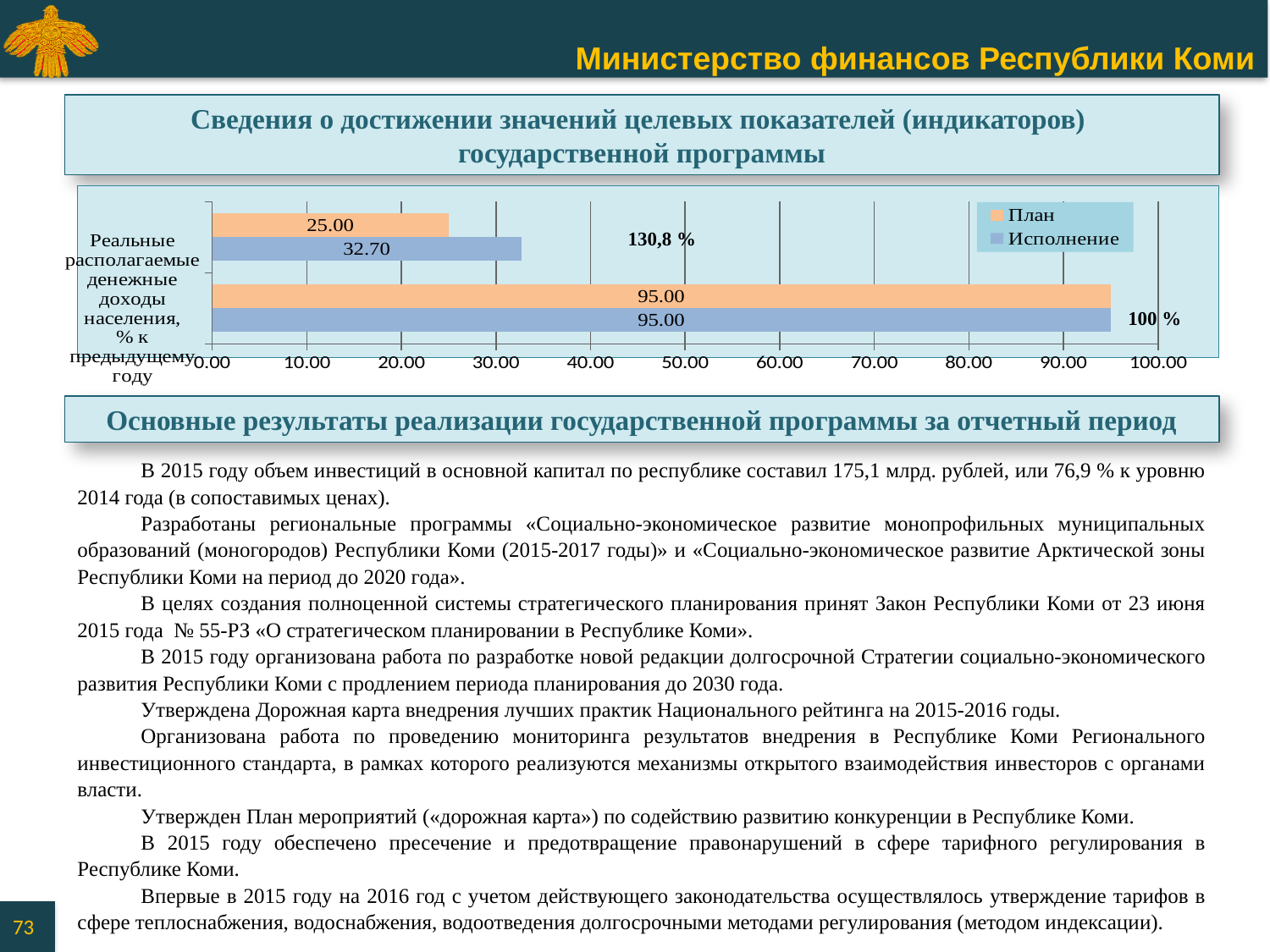
What is the value of the Исполнение bar in the bottom pair of bars? 95.00 How many series does the chart legend list? 2 What is the maximum value shown on the horizontal axis of the chart? 100.00 How many categories (pairs of bars) are plotted in the chart? 2 What is the value of the Исполнение bar in the top pair of bars? 32.70 What percentage is printed next to the top pair of bars? 130,8 % What type of chart is shown on the slide? bar chart What is the value of the План bar in the bottom pair of bars? 95.00 What are the two series named in the chart legend? План, Исполнение In the top pair of bars, what is the difference between the Исполнение value and the План value? 7.70 What is the value of the План bar in the top pair of bars? 25.00 In the top pair of bars, which is larger: План or Исполнение? Исполнение